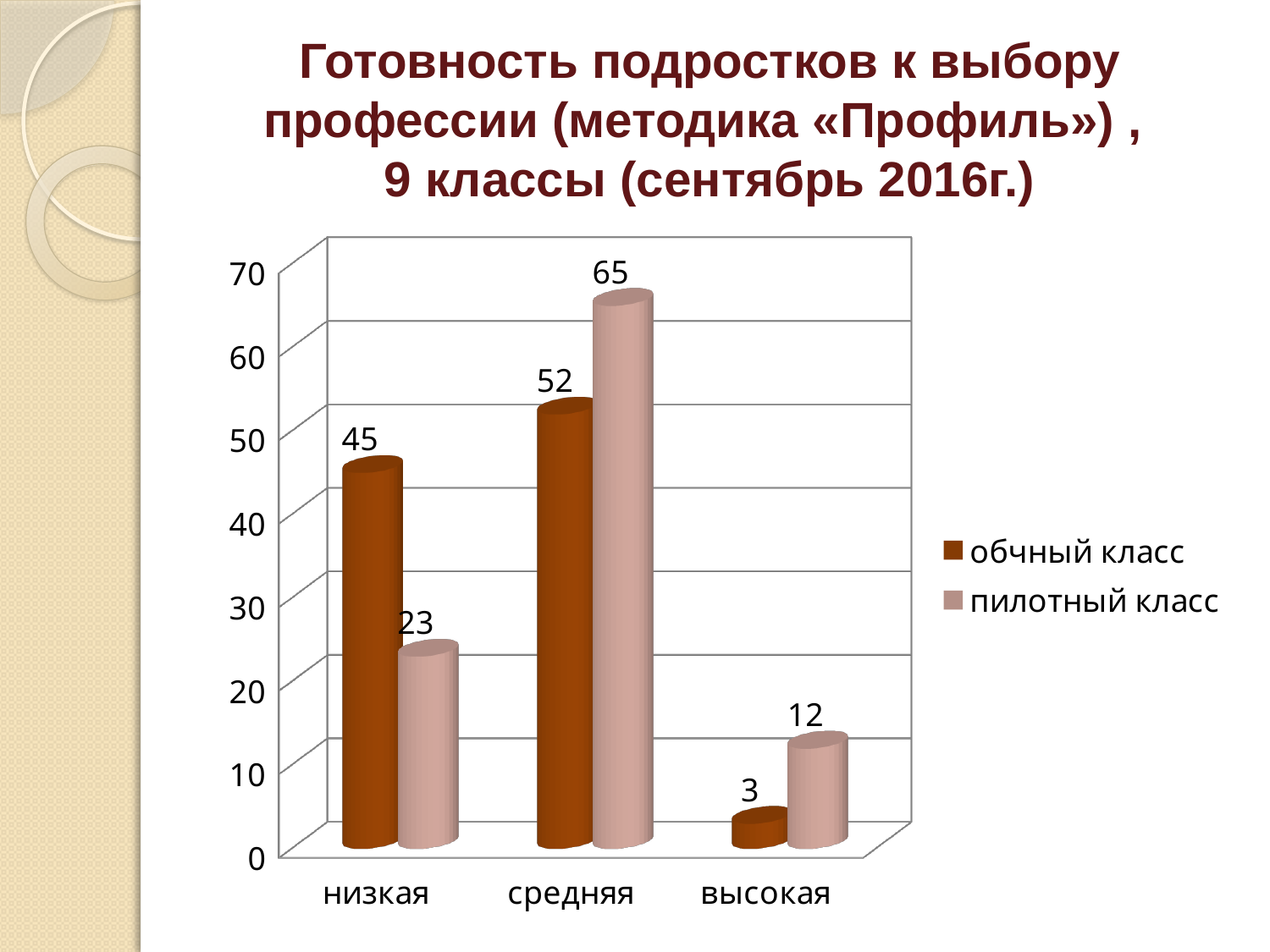
How many series does the legend list? 2 What is the value for 'пилотный класс' in the 'средняя' category? 65 What is the value for 'пилотный класс' in the 'низкая' category? 23 How many categories are shown on the x axis? 3 What is the difference between 'пилотный класс' and 'обчный класс' in the 'средняя' category? 13 Which category has the highest value for 'пилотный класс'? средняя What is the difference between 'обчный класс' and 'пилотный класс' in the 'низкая' category? 22 What is the value for 'обчный класс' in the 'высокая' category? 3 What kind of chart is shown on the slide? bar chart In the 'низкая' category, which series has the larger value, 'обчный класс' or 'пилотный класс'? обчный класс Which category has the lowest value for 'обчный класс'? высокая What is the value for 'обчный класс' in the 'низкая' category? 45